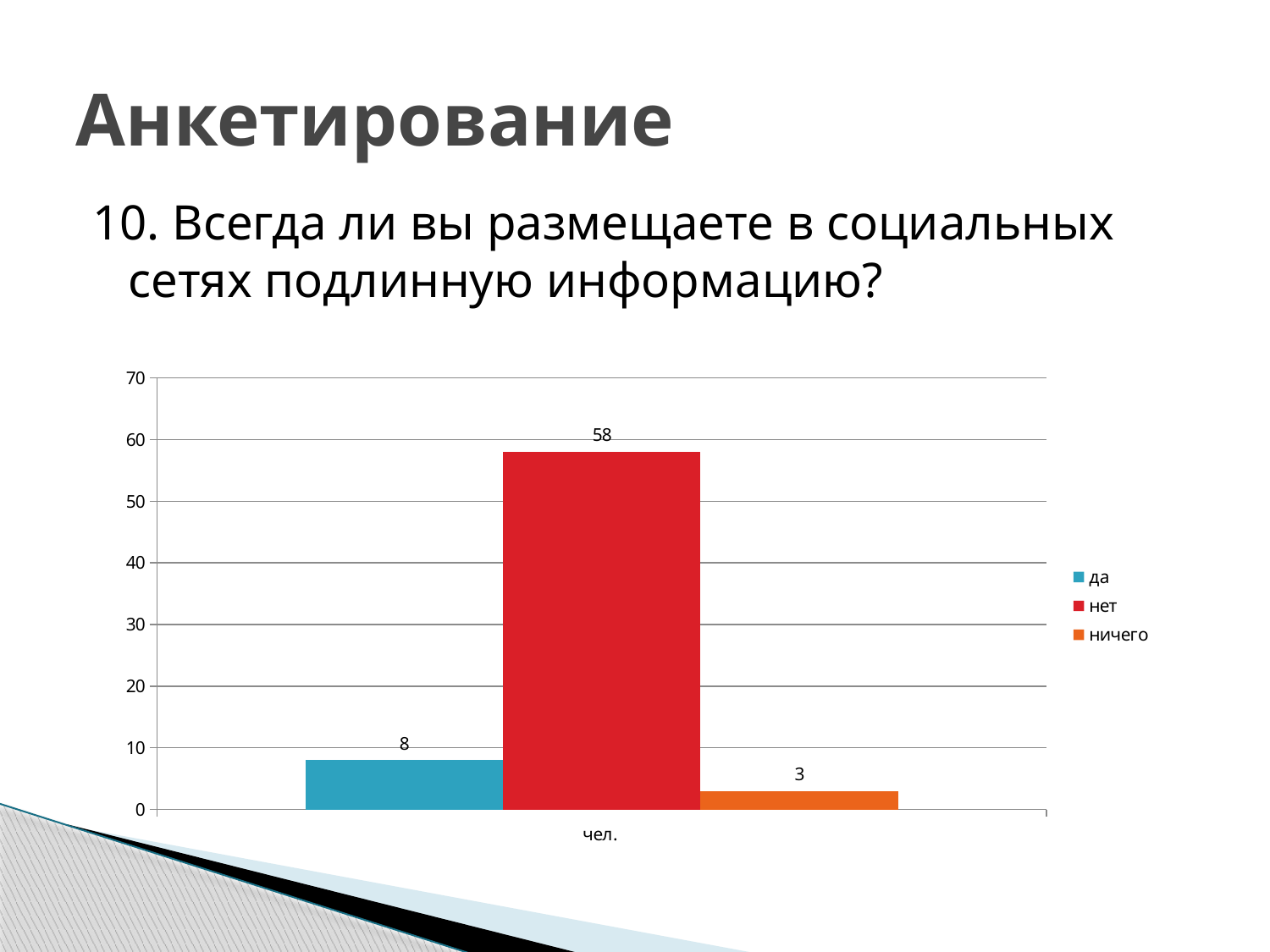
What is the value for "ничего"? 3 What is the difference between the values for "да" and "ничего"? 5 What kind of chart is shown on the slide? bar chart What is the value for "нет"? 58 What is the label shown on the x axis of the chart? чел. Which series has the highest value? нет What is the difference between the values for "нет" and "да"? 50 Which series has the lowest value? ничего Which is larger, the value for "да" or the value for "ничего"? да Is the value for "нет" greater or less than 50? greater How many series does the legend list? 3 What is the value for "да"? 8